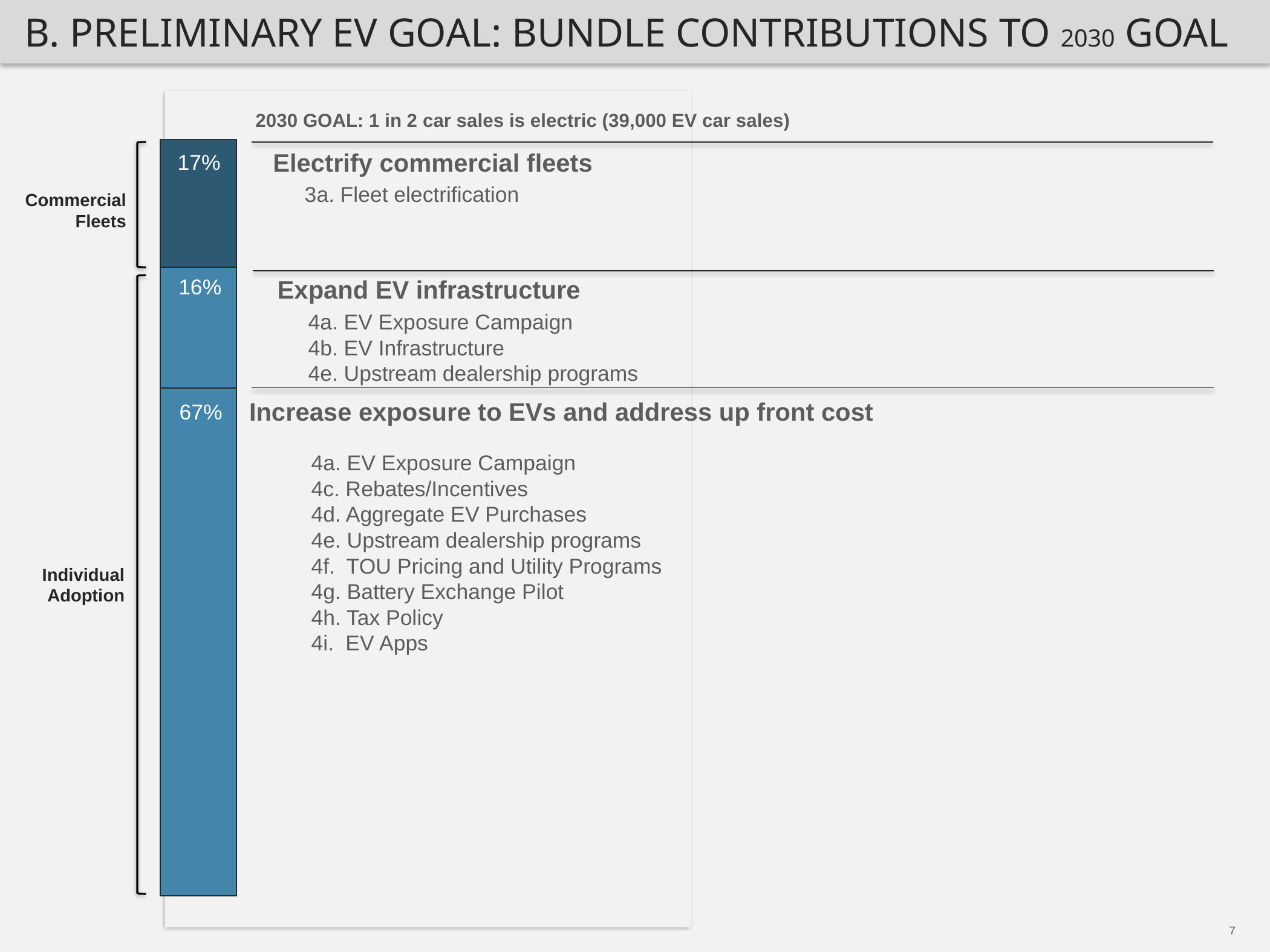
What is the difference in percentage points between the 'Increase exposure to EVs and address up front cost' bundle and the 'Electrify commercial fleets' bundle? 50 What percentage of the 2030 goal is contributed by the 'Expand EV infrastructure' bundle? 16% What percentage of the 2030 goal is contributed by the 'Increase exposure to EVs and address up front cost' bundle? 67% Which bundle contributes the smallest share to the 2030 goal? Expand EV infrastructure What is the 2030 goal stated above the chart? 1 in 2 car sales is electric (39,000 EV car sales) What is the total of all three segments in the stacked bar? 100% What kind of chart is shown on the slide? Stacked bar chart What is the combined percentage of the two segments grouped under 'Individual Adoption'? 83% What percentage of the 2030 goal is contributed by the 'Electrify commercial fleets' bundle? 17% How many segments make up the stacked bar? 3 Which contributes more to the 2030 goal: 'Electrify commercial fleets' or 'Expand EV infrastructure'? Electrify commercial fleets Which bundle contributes the largest share to the 2030 goal? Increase exposure to EVs and address up front cost